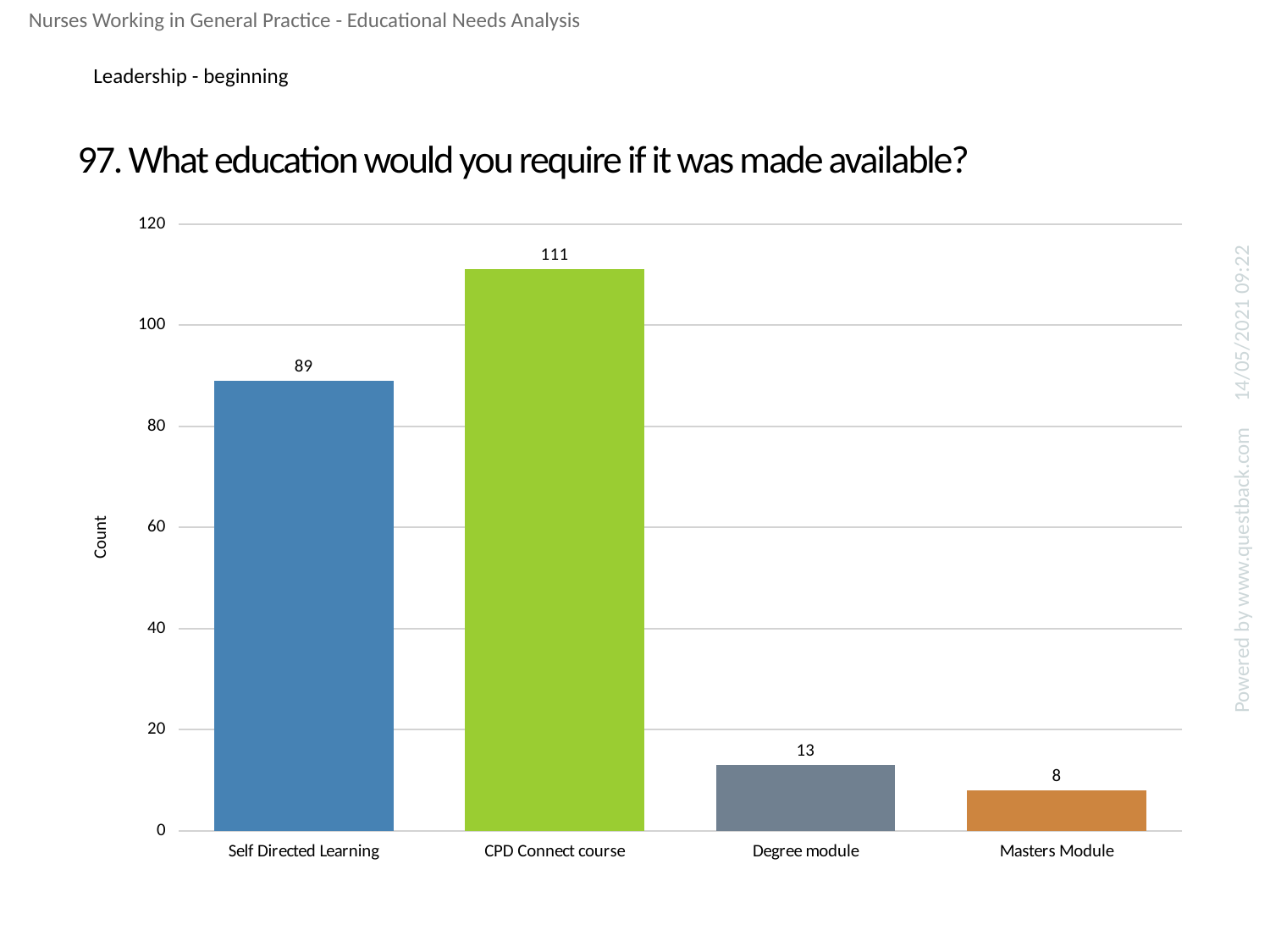
What is the count for Self Directed Learning? 89 What is the difference between the counts for CPD Connect course and Self Directed Learning? 22 How many categories are shown on the x axis? 4 Which category has the highest count? CPD Connect course Is the value for Self Directed Learning greater or less than 80? greater Which has a larger count, Degree module or Masters Module? Degree module What kind of chart is shown on the slide? bar chart What is the count for Degree module? 13 What is the count for CPD Connect course? 111 Which category has the lowest count? Masters Module What is the count for Masters Module? 8 What is the label on the vertical axis? Count